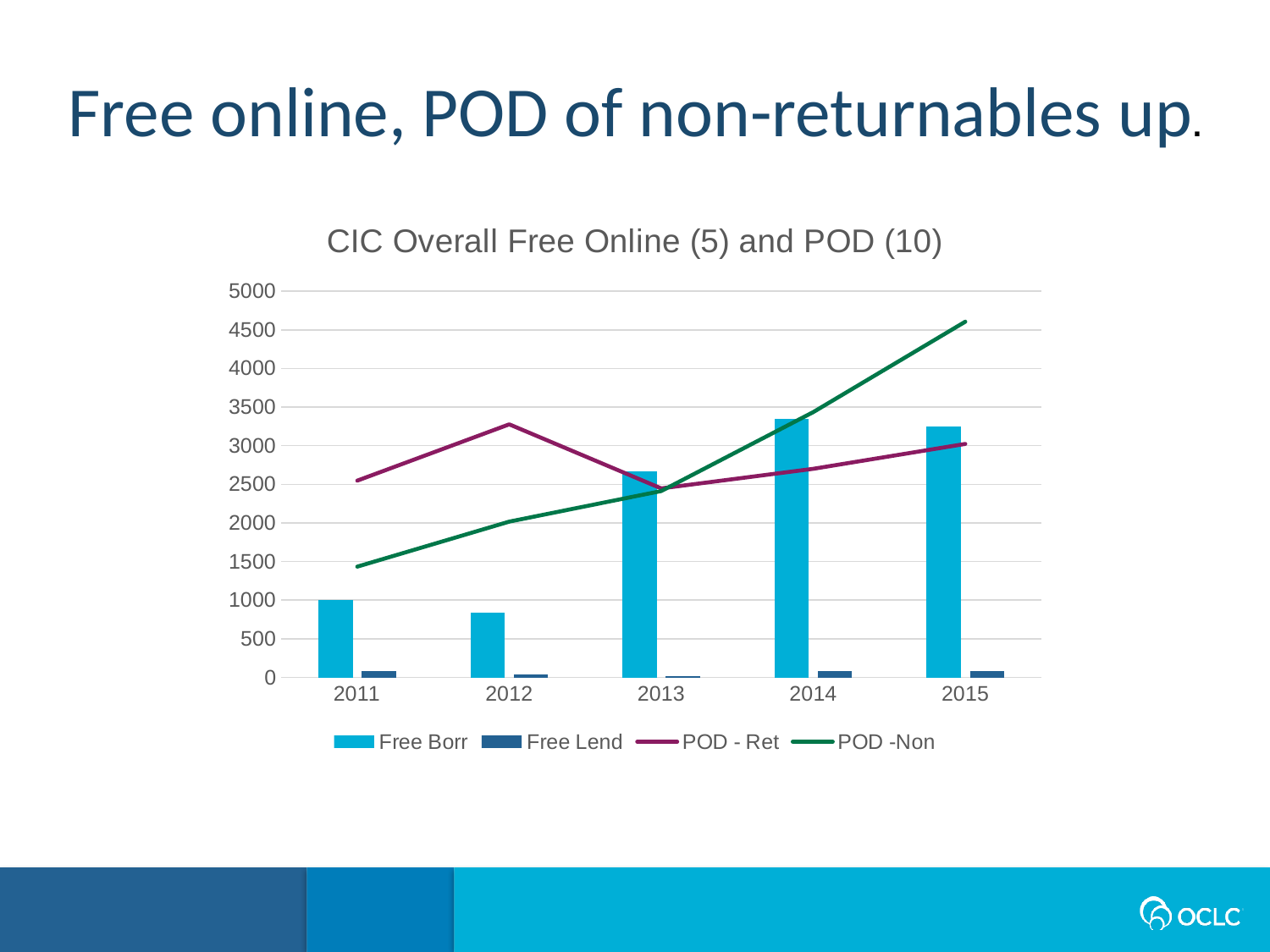
In which year is the Free Borr bar the shortest? 2012 In which year is the POD -Non line at its highest? 2015 Is the value for Free Borr in 2011 greater or less than 1500? less Is the value for POD -Non in 2015 greater or less than 4000? greater In 2011, which is larger: POD - Ret or POD -Non? POD - Ret How many years are shown on the x axis? 5 How many series does the legend list? 4 In which year is the POD - Ret line at its highest? 2012 Does the POD -Non line rise or fall from 2011 to 2015? Rises In which year is the POD - Ret line at its lowest? 2013 What kind of chart is this? Combined bar and line chart What is the title of the chart? CIC Overall Free Online (5) and POD (10)